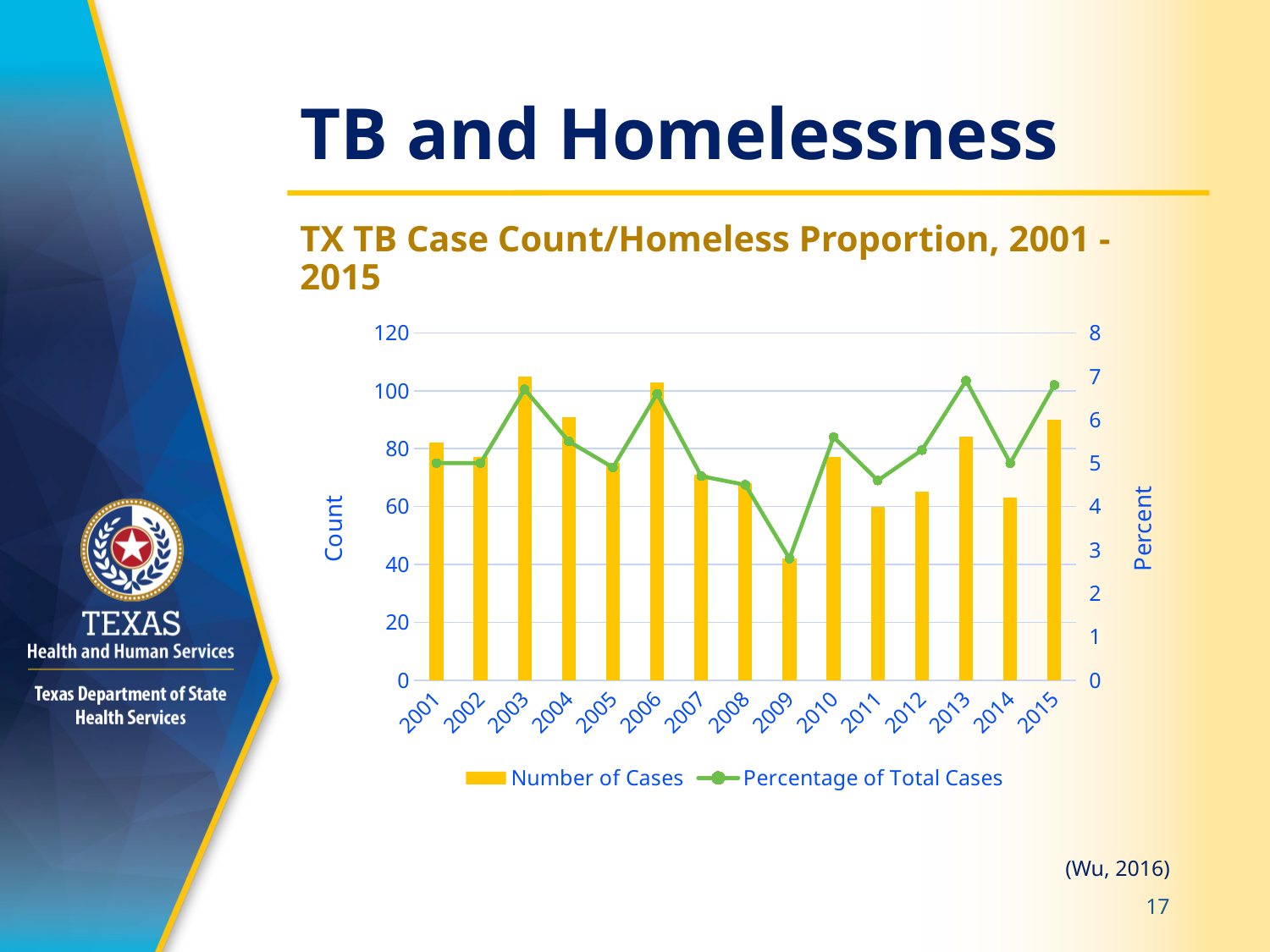
Is the Percentage of Total Cases for 2009 greater or less than 4? less Which year has the lowest Number of Cases? 2009 How many years are shown on the x axis? 15 Is the Number of Cases for 2009 greater or less than 60? less What is the label of the right-hand vertical axis? Percent Which year has a larger Number of Cases, 2004 or 2005? 2004 What kind of chart is shown on the slide? A combination bar and line chart How many series does the legend list? 2 Is the Number of Cases for 2003 greater or less than 100? greater Which year has the highest Number of Cases? 2003 Do the Number of Cases values rise or fall from 2006 to 2009? fall Which year has the lowest Percentage of Total Cases? 2009